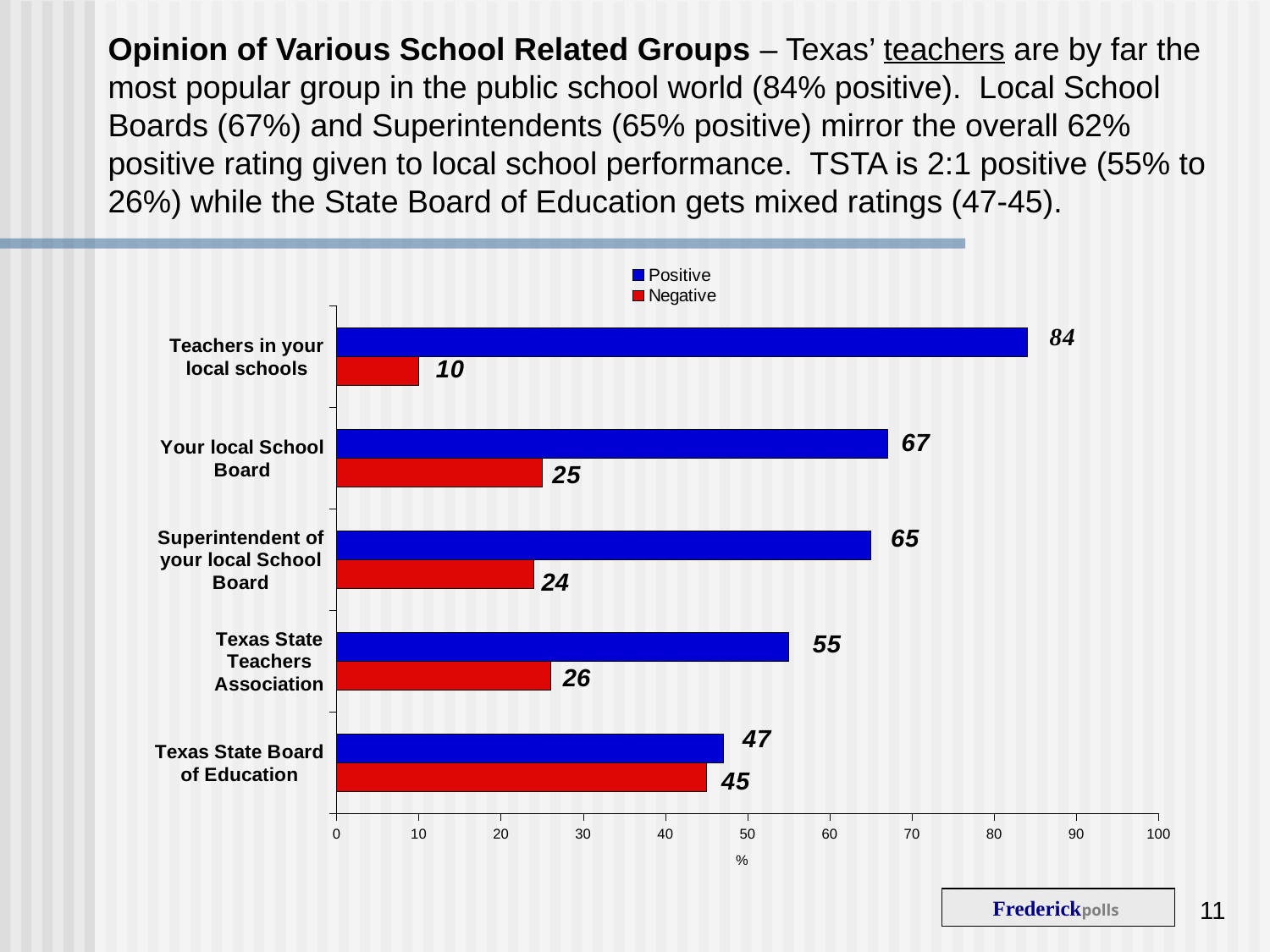
What is the Negative value for Your local School Board? 25 Which group has the lowest Negative value? Teachers in your local schools What is the difference between the Positive and Negative values for Texas State Teachers Association? 29 Which is larger: the Positive value for Your local School Board or the Positive value for Superintendent of your local School Board? Your local School Board What colour are the Negative bars? red What kind of chart is shown on the slide? bar chart What is the Negative value for Texas State Board of Education? 45 Which group has the highest Positive value? Teachers in your local schools How many series does the legend list? 2 How many groups are shown on the chart? 5 Is the Positive value for Texas State Board of Education greater or less than 50? less What is the Positive value for Teachers in your local schools? 84